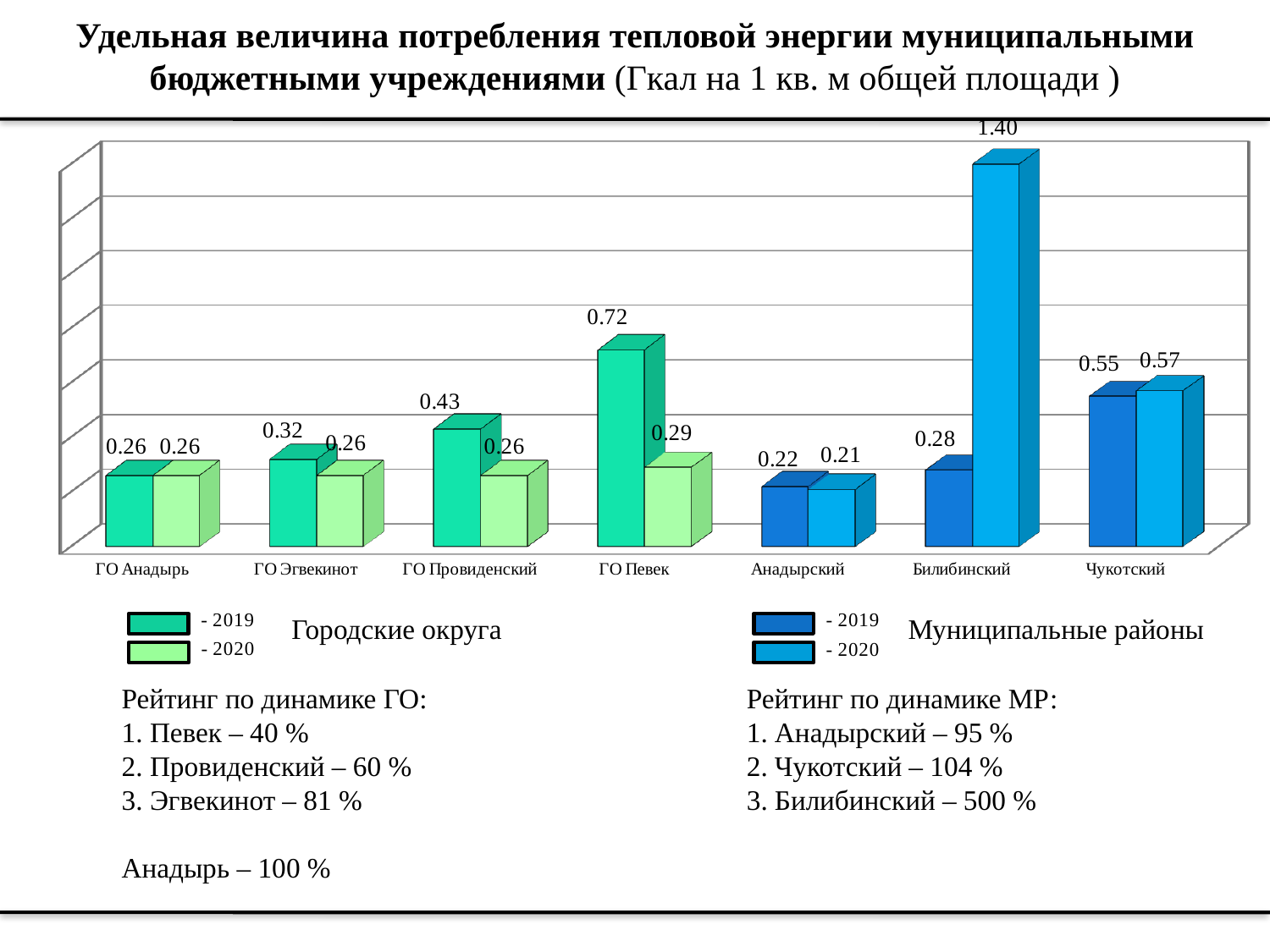
Which two years are listed in the chart legend? 2019 and 2020 What is the difference between the 2019 and 2020 values for ГО Певек? 0.43 Which category has the highest 2020 value? Билибинский What is the 2019 value for ГО Провиденский? 0.43 What kind of chart is shown on the slide? Bar chart What is the 2020 value for Билибинский? 1.40 Which is larger: the 2019 value for ГО Эгвекинот or the 2019 value for ГО Провиденский? ГО Провиденский What is the difference between the 2020 and 2019 values for Билибинский? 1.12 What is the 2019 value for ГО Певек? 0.72 How many categories are shown on the x axis of the chart? 7 What is the 2020 value for Чукотский? 0.57 Which category has the lowest 2019 value? Анадырский